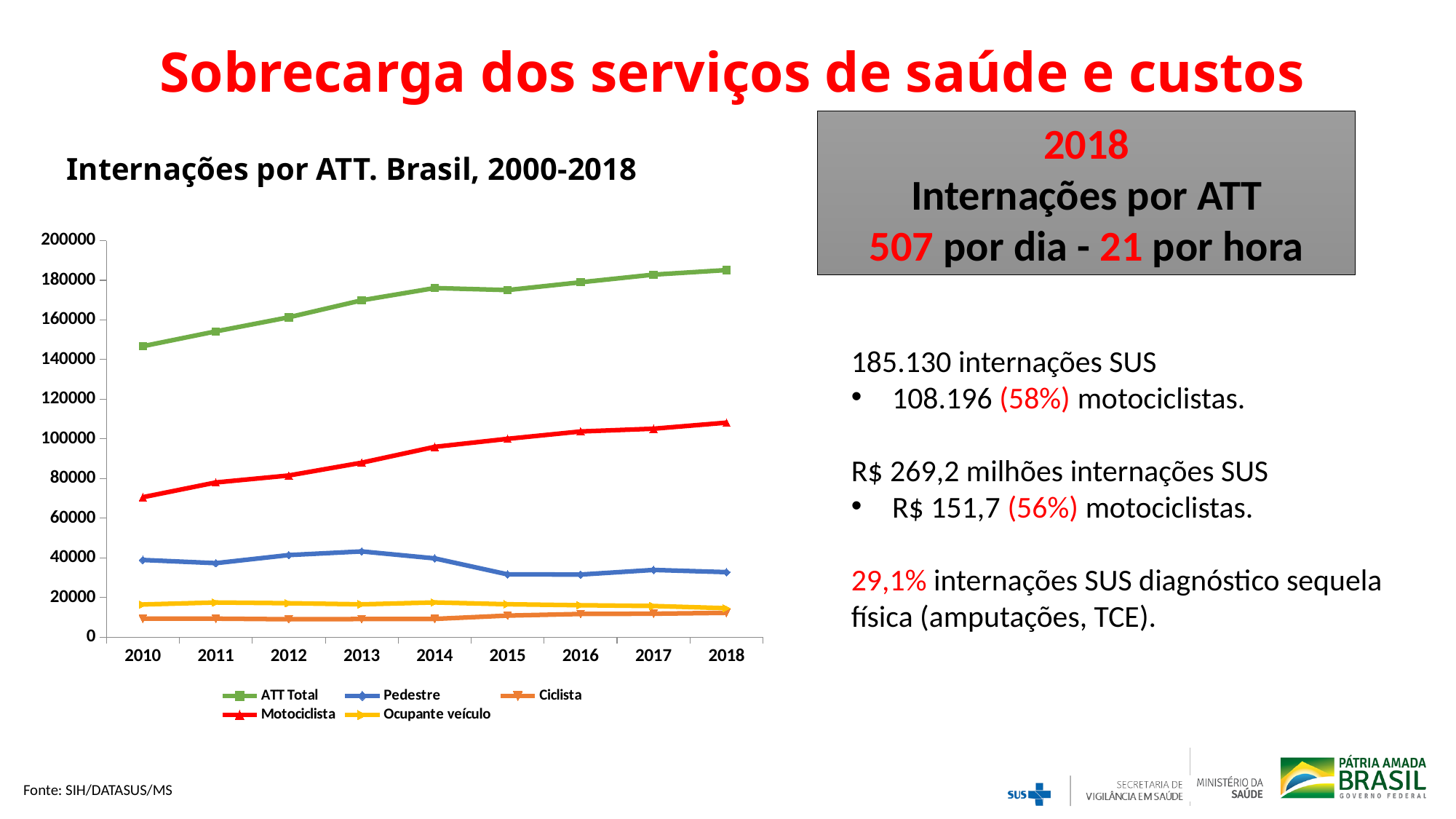
Which series has the lowest value in 2010? Ciclista How many years are plotted along the x axis of the chart? 9 Is the value for ATT Total in 2018 greater or less than 180000? greater Which series has the highest value in 2018? ATT Total What kind of chart is shown on the slide? line chart How many series does the chart legend list? 5 What is the title of the chart? Internações por ATT. Brasil, 2000-2018 Is the value for Pedestre in 2015 greater or less than 40000? less Does the Motociclista series rise or fall from 2010 to 2018? rise Does the ATT Total series rise or fall from 2010 to 2018? rise Is the value for Motociclista in 2018 greater or less than 100000? greater